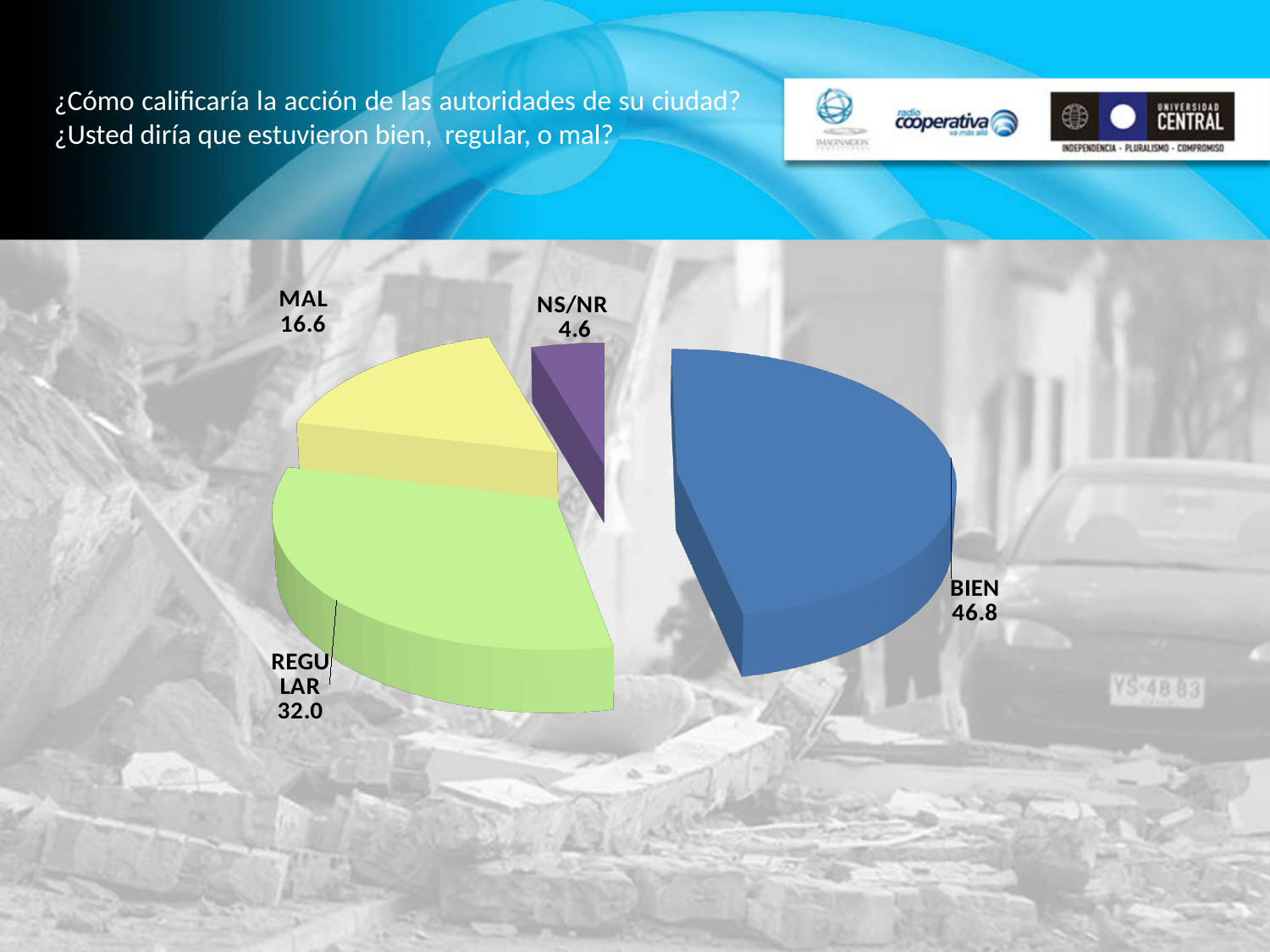
What is the value for BIEN? 46.8 What colour is the BIEN slice of the pie? blue What is the value for MAL? 16.6 How many categories (slices) does the pie chart have? 4 What is the difference between the values for BIEN and REGULAR? 14.8 Which is larger, the value for REGULAR or the value for MAL? REGULAR What is the value for REGULAR? 32.0 What kind of chart is shown on the slide? pie chart What is the value for NS/NR? 4.6 Which category has the smallest slice of the pie? NS/NR Which category has the largest slice of the pie? BIEN What is the difference between the values for MAL and NS/NR? 12.0